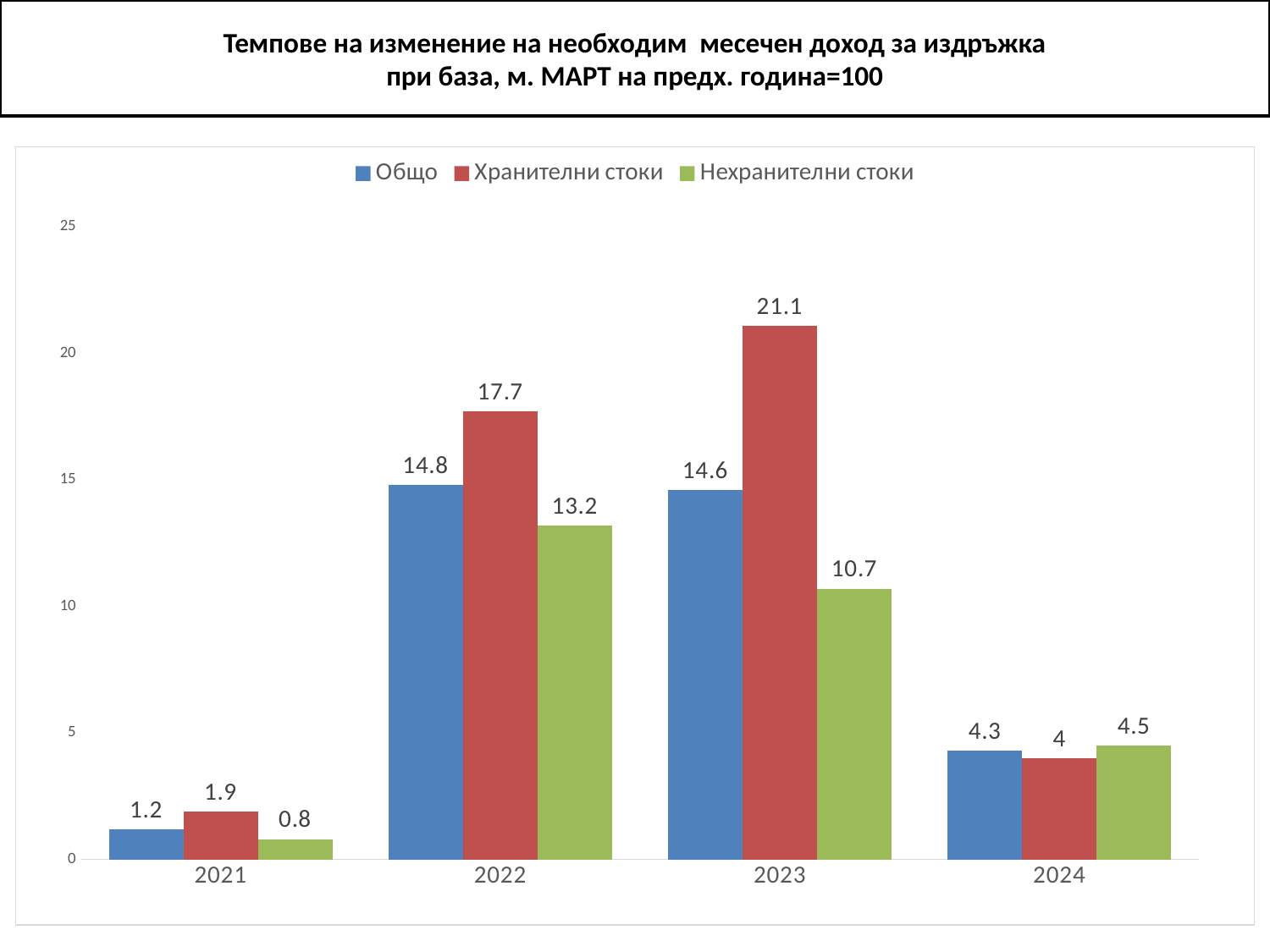
How many years are shown on the x axis? 4 What is the value for Хранителни стоки in 2024? 4 What kind of chart is shown on the slide? bar chart What is the value for Нехранителни стоки in 2021? 0.8 In which year is the value for Хранителни стоки highest? 2023 In which year is the value for Общо lowest? 2021 Is the value for Хранителни стоки in 2023 greater or less than 20? greater What is the difference between Хранителни стоки and Нехранителни стоки in 2023? 10.4 What is the value for Общо in 2022? 14.8 What is the value for Хранителни стоки in 2023? 21.1 How many series does the legend list? 3 Which is larger in 2022: Хранителни стоки or Нехранителни стоки? Хранителни стоки